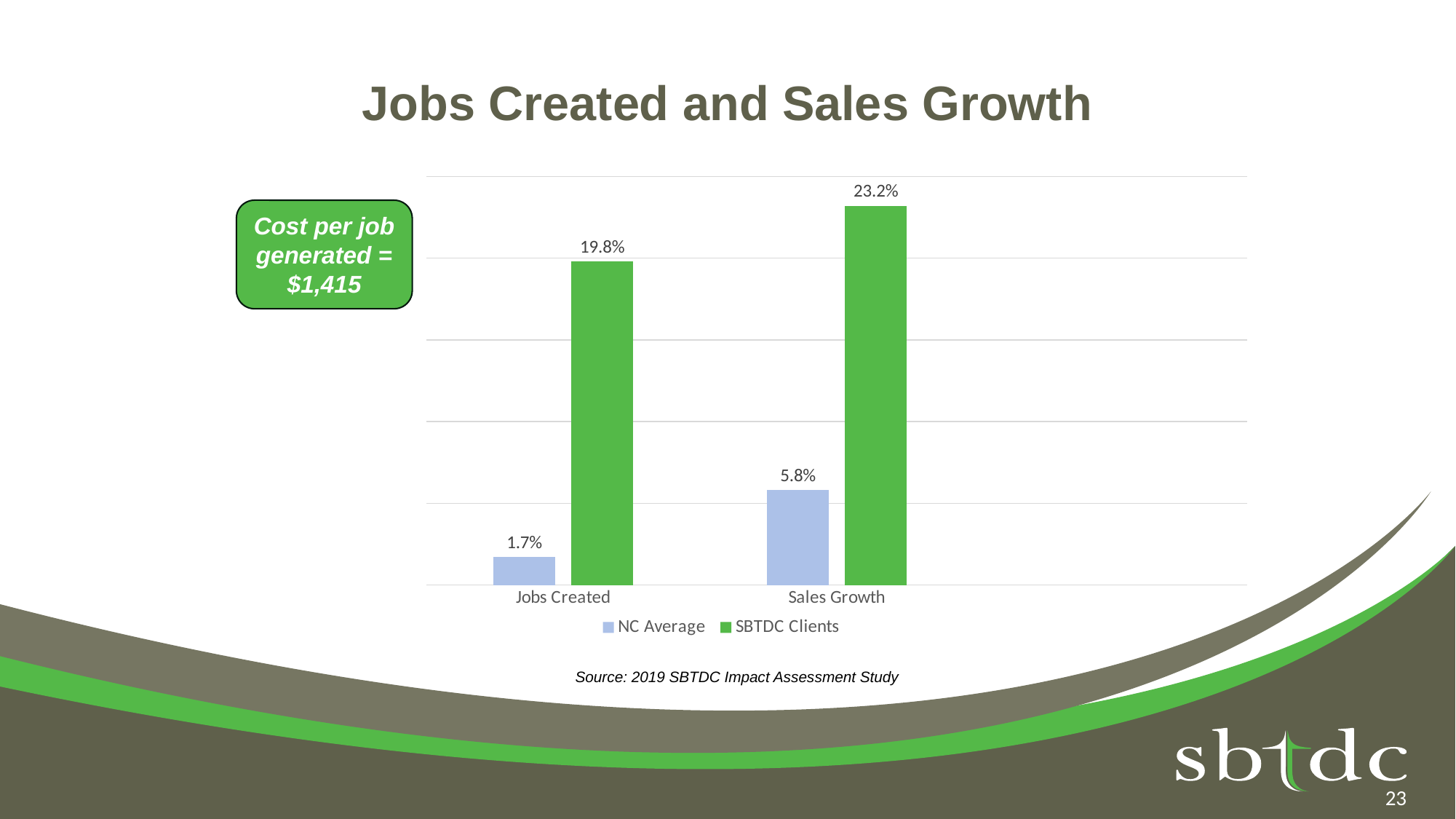
How many categories are shown on the x axis? 2 Which is larger: the NC Average value for Sales Growth or the NC Average value for Jobs Created? Sales Growth How many series does the legend list? 2 What is the SBTDC Clients value for Sales Growth? 23.2% Which bar has the lowest value on the chart? NC Average, Jobs Created What is the difference between the SBTDC Clients and NC Average values for Jobs Created? 18.1% What kind of chart is shown on the slide? Bar chart What is the difference between the SBTDC Clients and NC Average values for Sales Growth? 17.4% What is the NC Average value for Sales Growth? 5.8% Which bar has the highest value on the chart? SBTDC Clients, Sales Growth What is the NC Average value for Jobs Created? 1.7% What is the SBTDC Clients value for Jobs Created? 19.8%